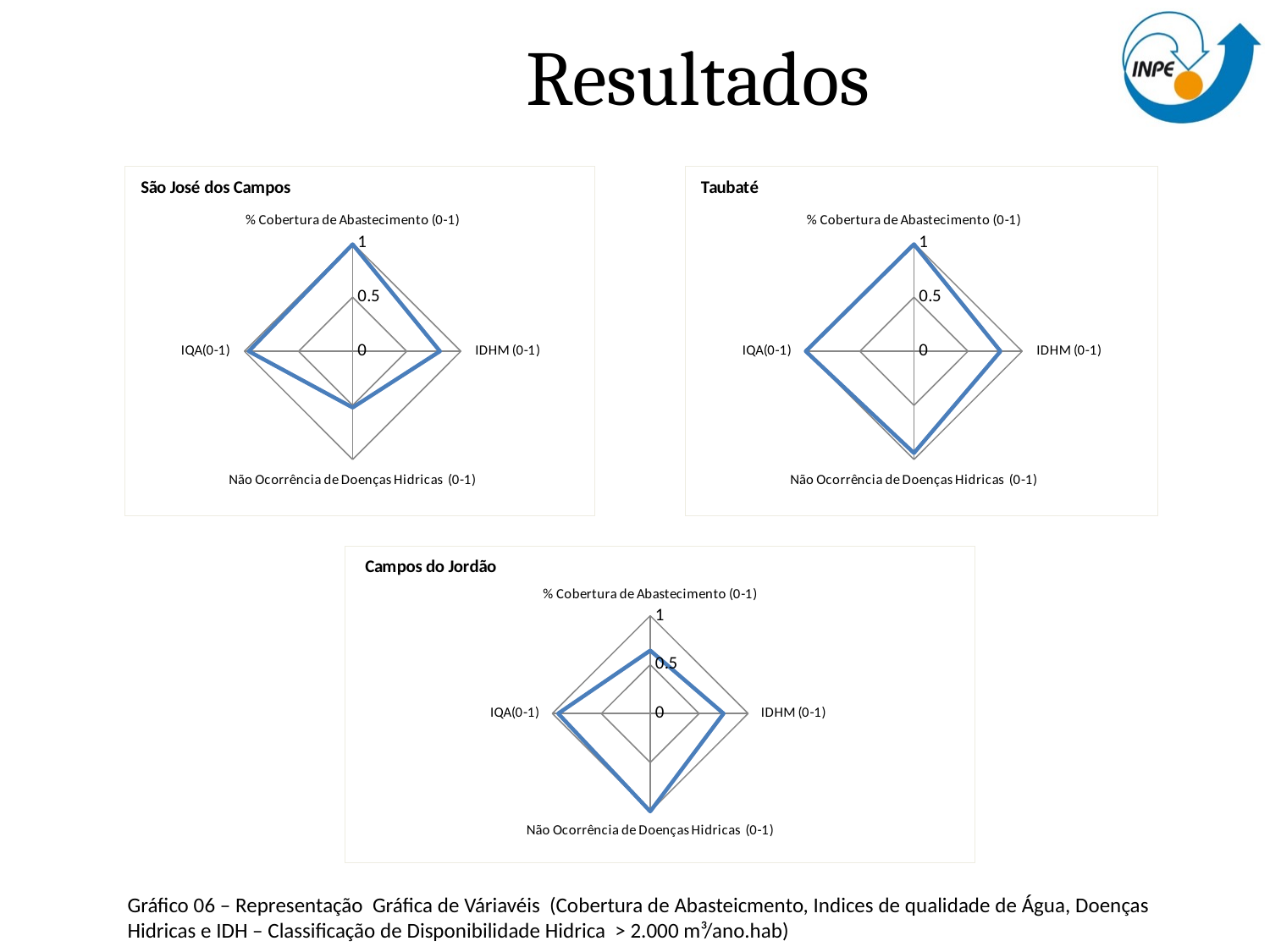
In the Campos do Jordão chart, which is larger: the value for Não Ocorrência de Doenças Hidricas (0-1) or the value for IDHM (0-1)? Não Ocorrência de Doenças Hidricas (0-1) In the Campos do Jordão chart, is the value for Não Ocorrência de Doenças Hidricas (0-1) greater or less than 0.5? greater What is the maximum value shown on the axis scale of the Taubaté radar chart? 1 In the Campos do Jordão chart, is the value for IQA(0-1) greater or less than 0.5? greater How many variables (axes) does the Taubaté radar chart show? 4 In the Taubaté chart, is the value for Não Ocorrência de Doenças Hidricas (0-1) greater or less than 0.5? greater What kind of chart is the São José dos Campos chart? radar chart What is the title of the radar chart at the bottom of the slide? Campos do Jordão In the São José dos Campos chart, which variable has the lowest value? Não Ocorrência de Doenças Hidricas (0-1) How many radar charts are shown on the slide? 3 In the São José dos Campos chart, which is larger: the value for IQA(0-1) or the value for Não Ocorrência de Doenças Hidricas (0-1)? IQA(0-1)